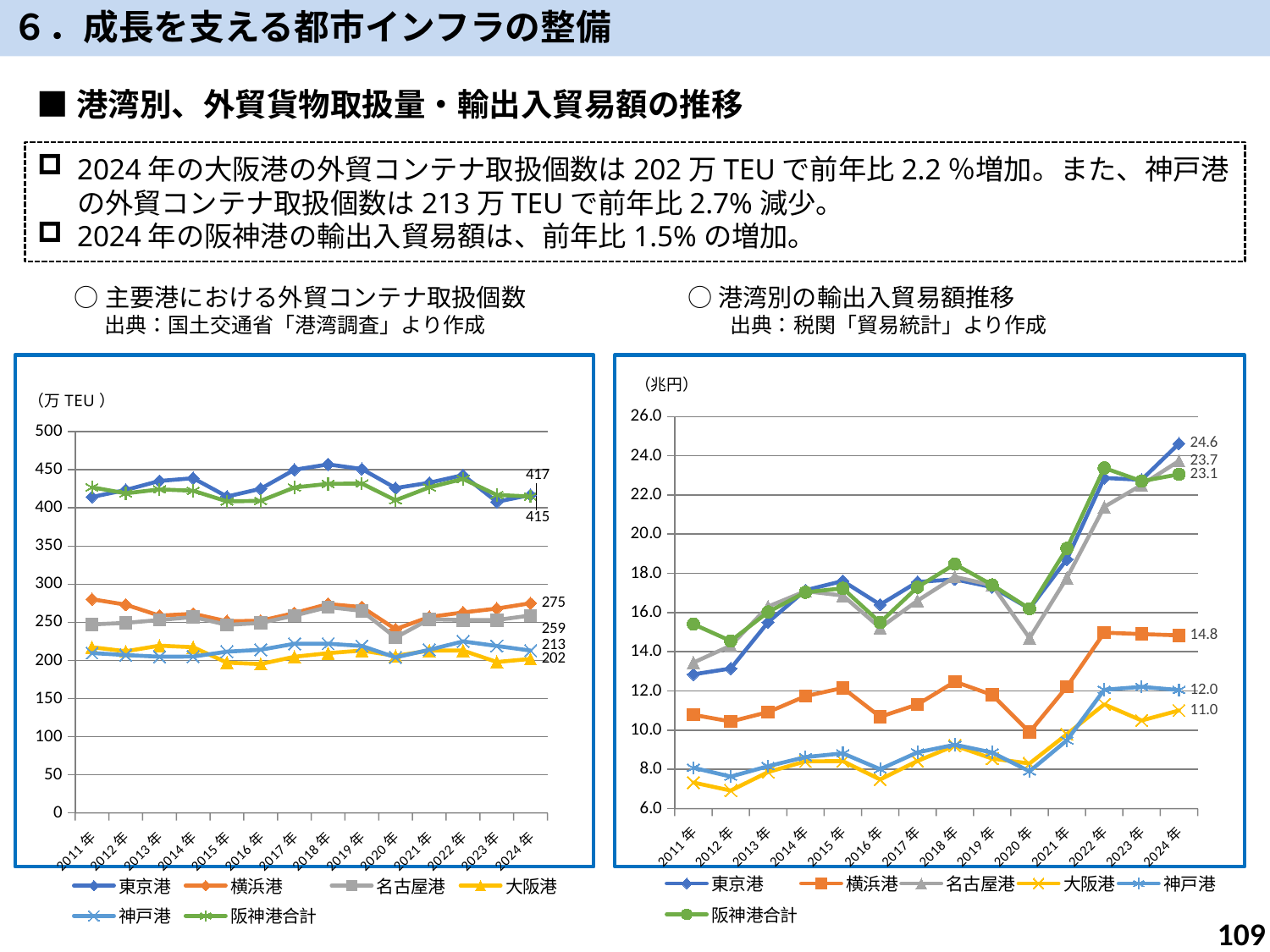
In the right chart, 港湾別の輸出入貿易額推移, is the value for 名古屋港 in 2020年 greater or less than 16.0? less In the left chart, 主要港における外貿コンテナ取扱個数, what is the value for 大阪港 in 2024年? 202 In the right chart, 港湾別の輸出入貿易額推移, which is larger in 2024年: 神戸港 or 大阪港? 神戸港 In the right chart, 港湾別の輸出入貿易額推移, what is the value for 横浜港 in 2024年? 14.8 In the right chart, 港湾別の輸出入貿易額推移, how many years are shown on the x axis? 14 In the left chart, 主要港における外貿コンテナ取扱個数, what is the value for 横浜港 in 2024年? 275 In the right chart, 港湾別の輸出入貿易額推移, what is the value for 東京港 in 2024年? 24.6 In the left chart, 主要港における外貿コンテナ取扱個数, what is the difference between 神戸港 (213) and 大阪港 (202) in 2024年? 11 In the right chart, 港湾別の輸出入貿易額推移, which series has the highest value in 2024年? 東京港 In the right chart, 港湾別の輸出入貿易額推移, how many series does the legend list? 6 In the left chart, 主要港における外貿コンテナ取扱個数, is the value for 東京港 in 2018年 greater or less than 450? greater What kind of chart is the left chart, 主要港における外貿コンテナ取扱個数? line chart